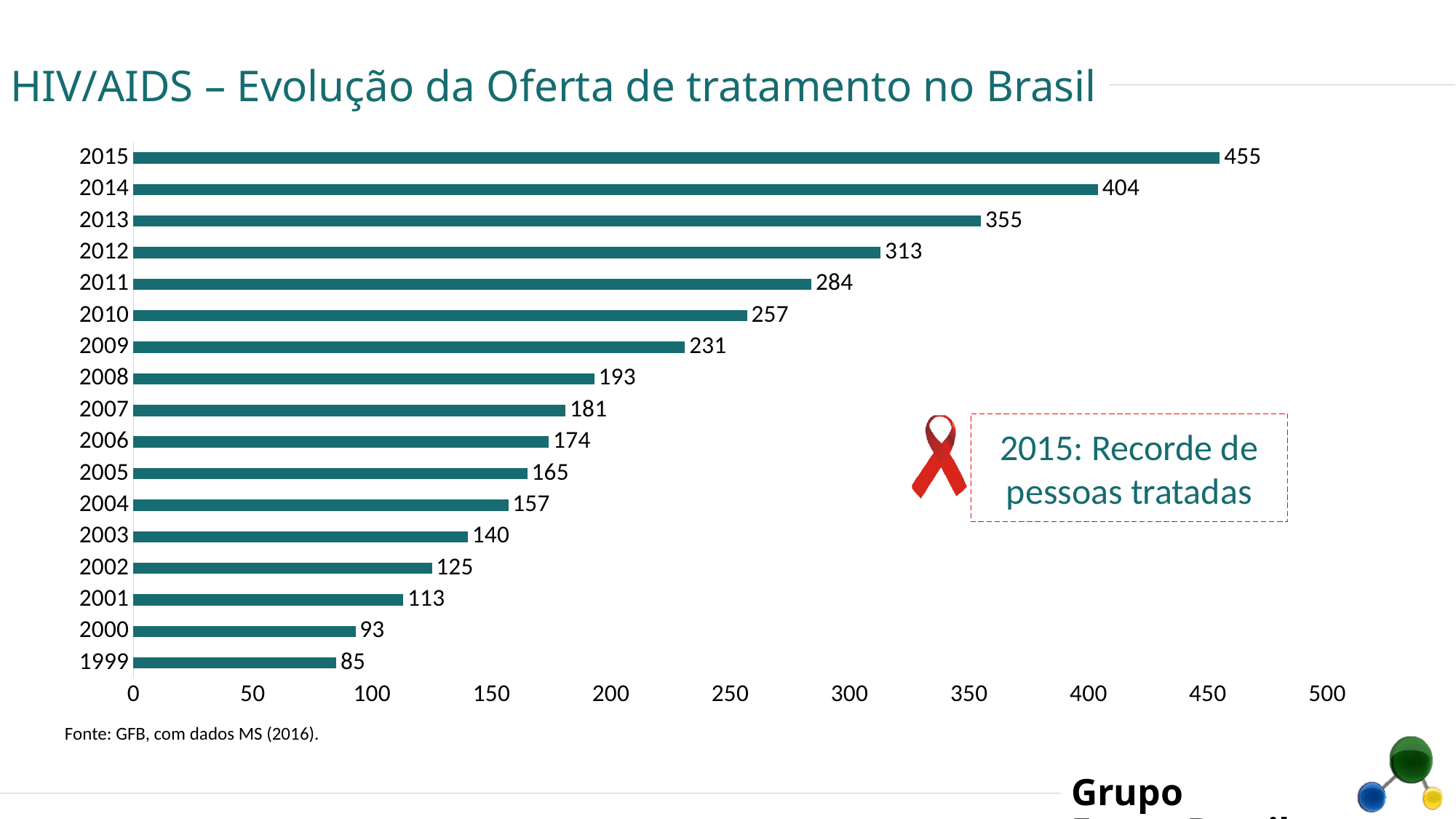
Which is larger, the value for 2012 or the value for 2011? 2012 Do the values rise or fall from 1999 to 2015? rise What is the value for 1999? 85 What is the value for 2015? 455 What is the difference between the values for 2015 and 2014? 51 What kind of chart is shown on the slide? bar chart What is the difference between the values for 2010 and 2009? 26 What is the value for 2008? 193 Which year has the highest value? 2015 Is the value for 2013 greater or less than 350? greater Which year has the lowest value? 1999 How many years are shown in the chart? 17